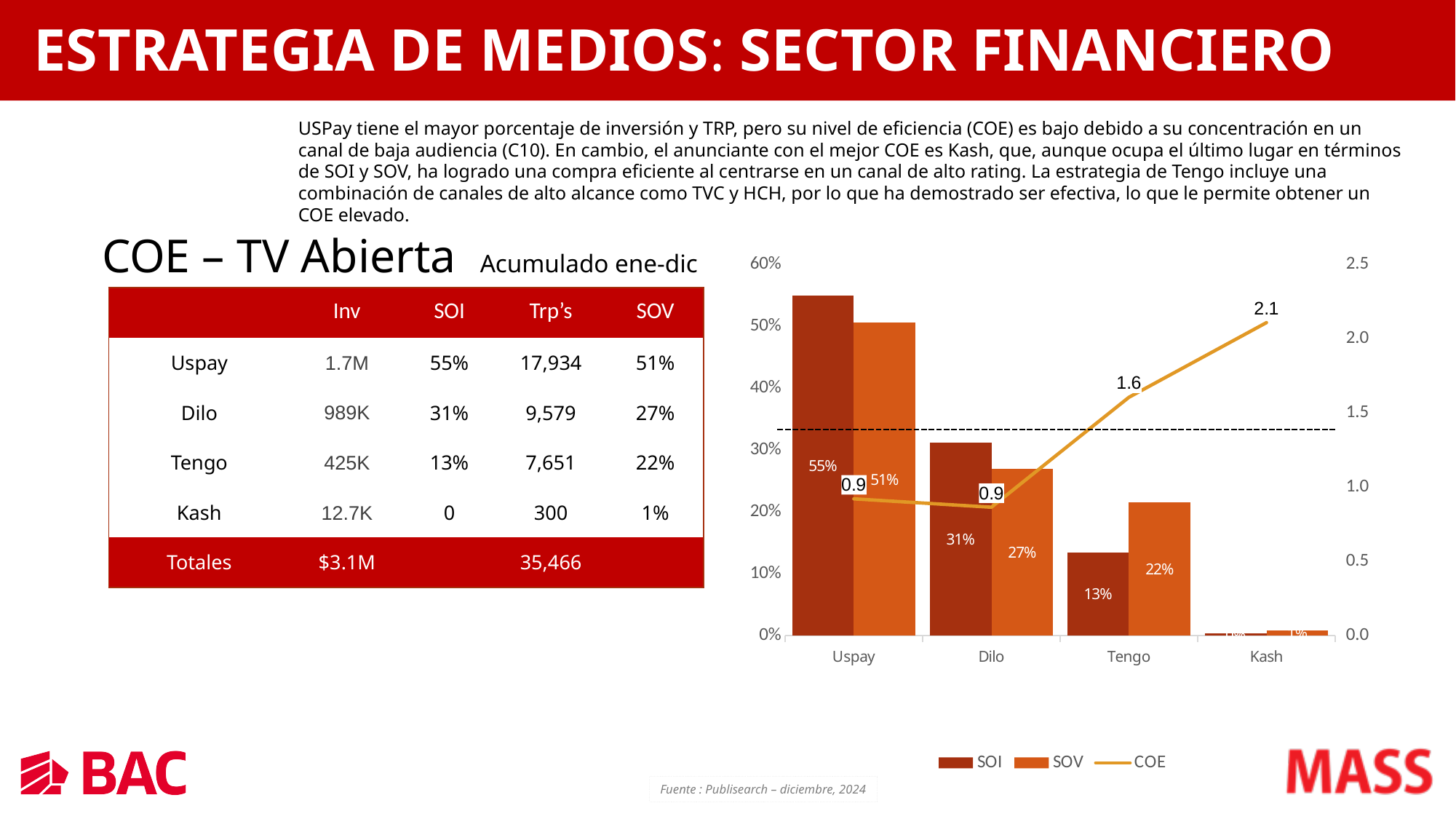
What is the COE value for Kash in the chart? 2.1 What is the SOV value for Dilo in the chart? 27% How many categories are shown on the x axis of the chart? 4 How many series does the chart legend list? 3 Which category has the highest SOV in the chart? Uspay Is the SOV value for Tengo greater or less than 20%? greater What is the difference between the SOI and SOV values for Tengo? 9% Which is larger for Dilo, SOI or SOV? SOI What is the COE value for Tengo in the chart? 1.6 What is the SOI value for Uspay in the chart? 55% Does the COE line rise or fall from Dilo to Kash? rise Which category has the lowest COE value shown on the line? Uspay and Dilo (both 0.9)